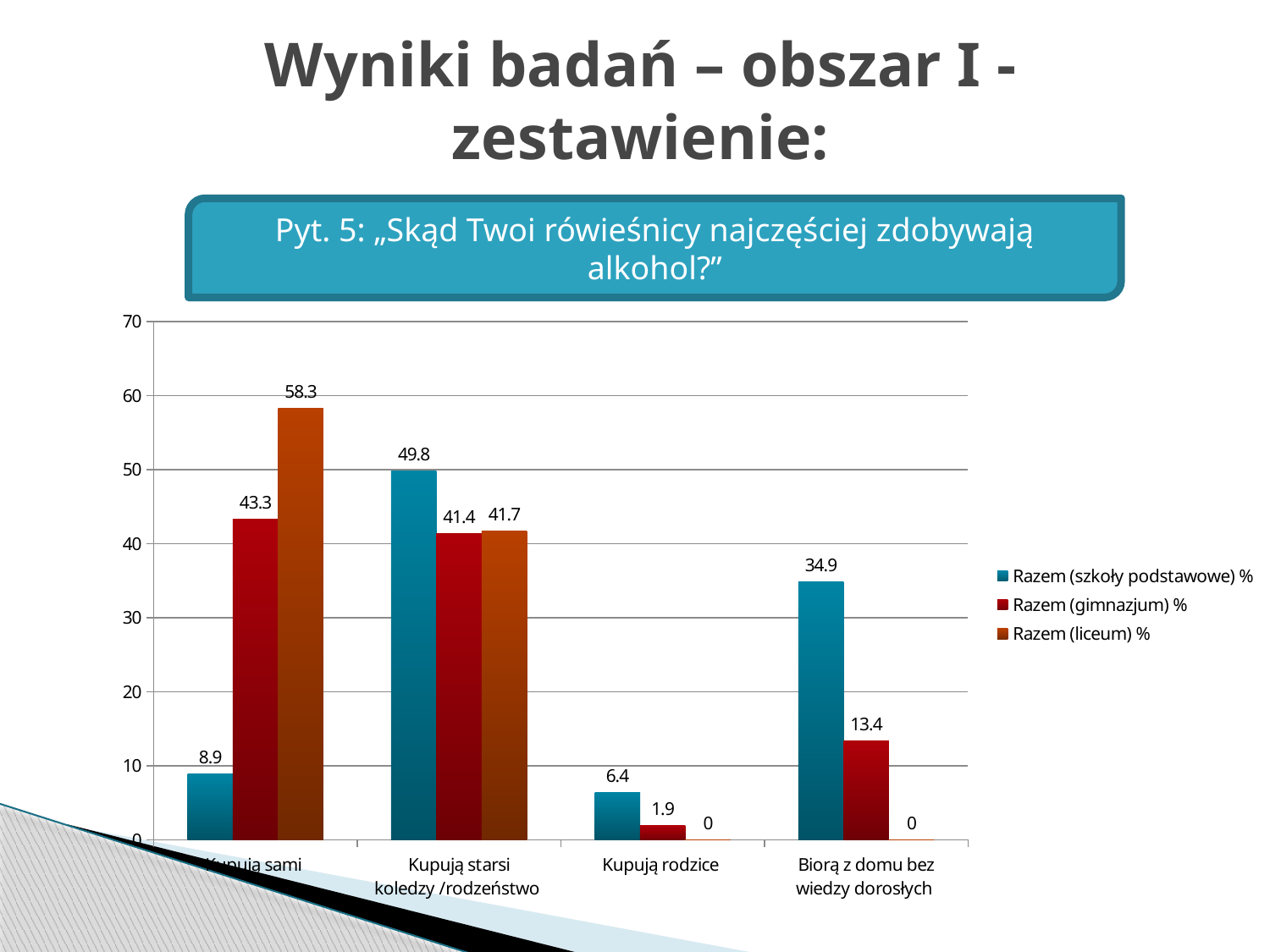
In the category "Kupują sami", what is the difference between the Razem (liceum) % value and the Razem (gimnazjum) % value? 15 What is the value for Razem (liceum) % in the category "Kupują sami"? 58.3 Which category has the highest value for Razem (szkoły podstawowe) %? Kupują starsi koledzy /rodzeństwo How many series does the legend list? 3 What is the value for Razem (szkoły podstawowe) % in the category "Biorą z domu bez wiedzy dorosłych"? 34.9 In the category "Kupują starsi koledzy /rodzeństwo", what is the difference between Razem (szkoły podstawowe) % and Razem (gimnazjum) %? 8.4 For Razem (szkoły podstawowe) %, which is larger: the value for "Kupują starsi koledzy /rodzeństwo" or the value for "Biorą z domu bez wiedzy dorosłych"? Kupują starsi koledzy /rodzeństwo What is the value for Razem (gimnazjum) % in the category "Kupują rodzice"? 1.9 How many categories are shown on the x axis of the chart? 4 What kind of chart is shown on the slide? bar chart Is the value for Razem (gimnazjum) % in "Biorą z domu bez wiedzy dorosłych" greater or less than 20? less Which category has the lowest value for Razem (gimnazjum) %? Kupują rodzice